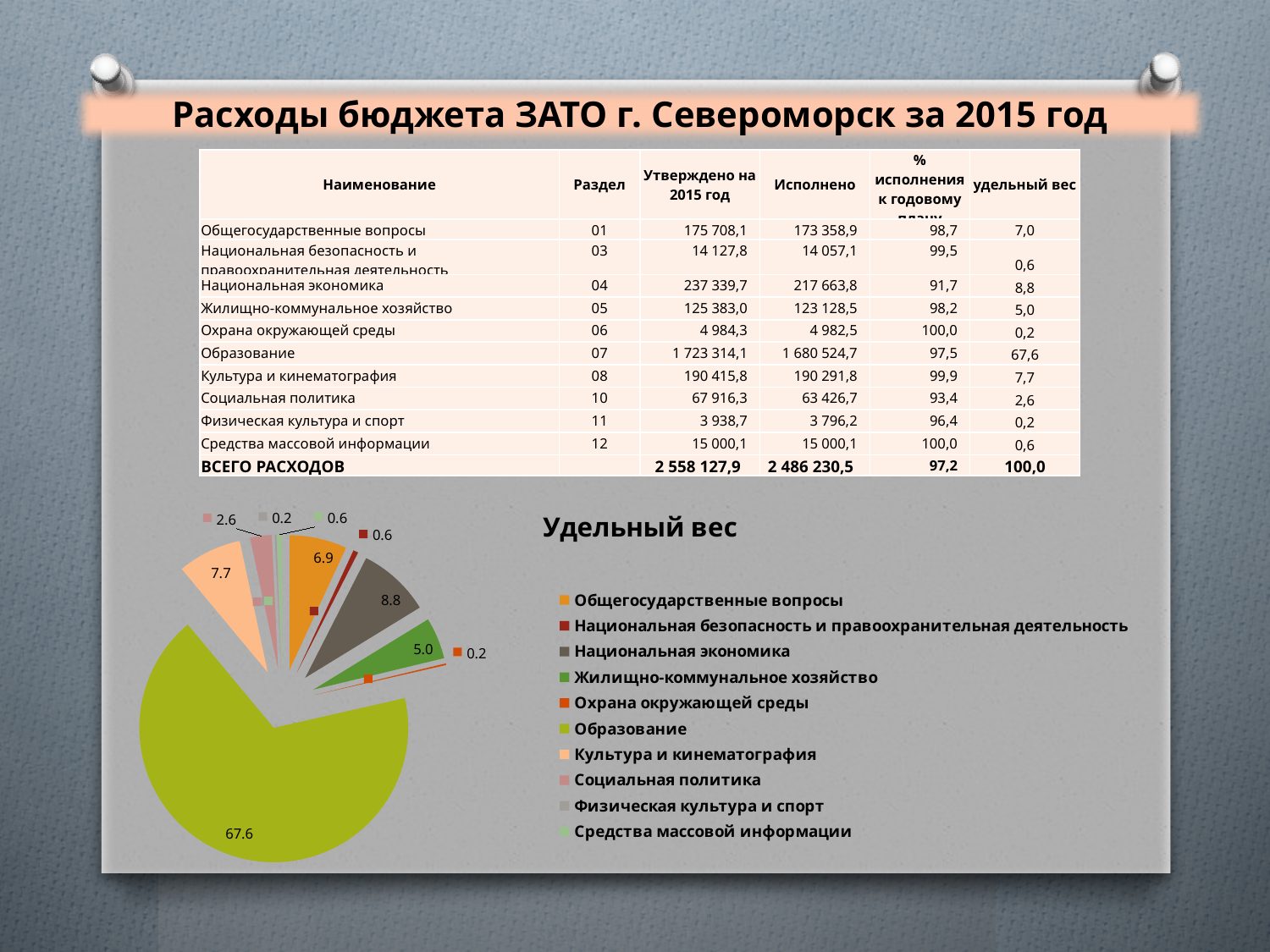
What is the value shown for Социальная политика in the pie chart? 2.6 What is the value shown for Национальная экономика in the pie chart? 8.8 How many categories does the chart's legend list? 10 Which is larger in the pie chart, Национальная экономика or Культура и кинематография? Национальная экономика What is the value shown for Образование in the pie chart? 67.6 What is the value shown for Жилищно-коммунальное хозяйство in the pie chart? 5.0 What is the difference between the values for Образование and Национальная экономика in the pie chart? 58.8 Which category has the largest slice in the pie chart? Образование What is the title of the chart? Удельный вес What colour is the slice for Образование in the pie chart? Yellow-green What kind of chart is shown on the slide? Pie chart What is the value shown for Культура и кинематография in the pie chart? 7.7